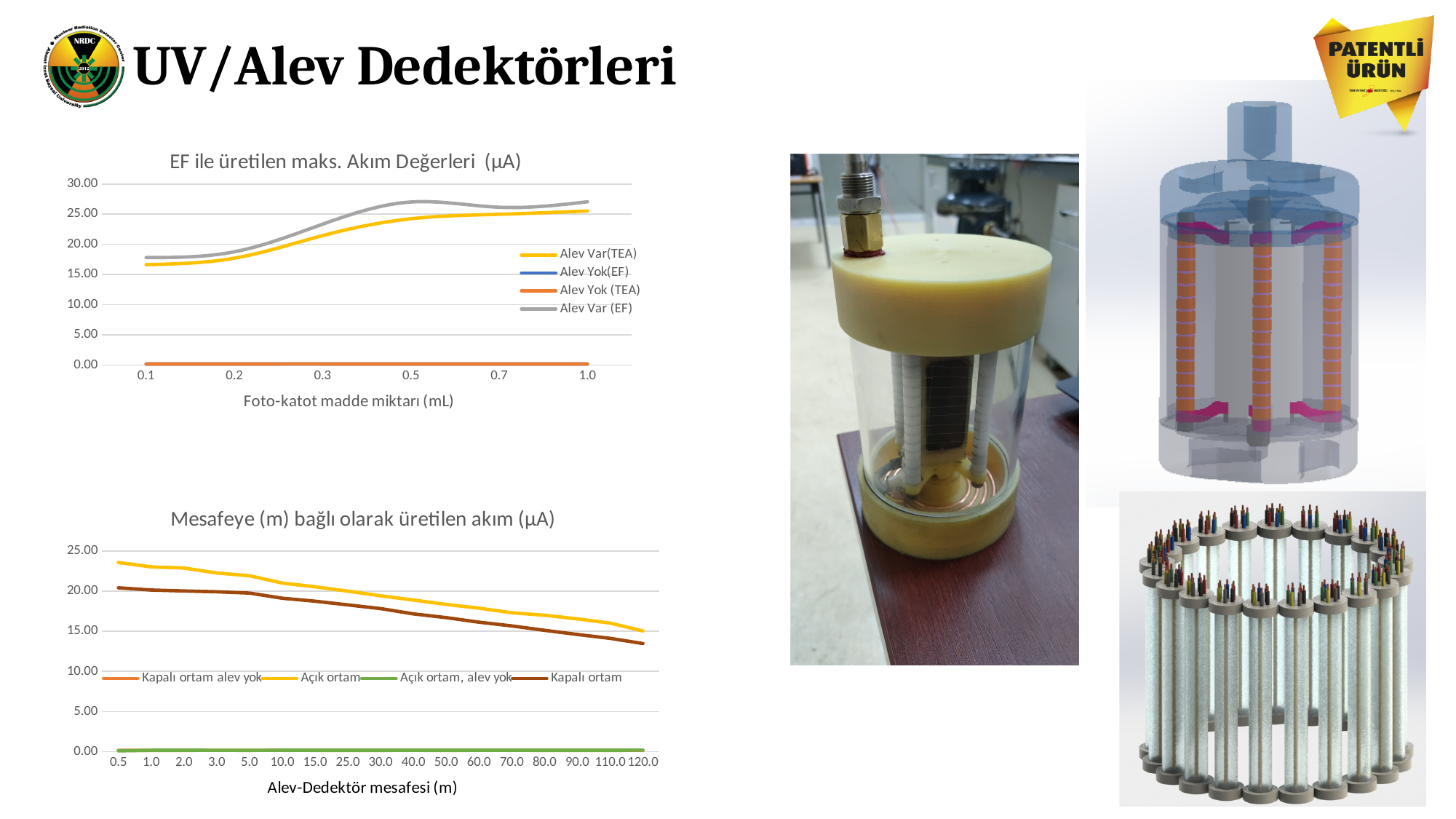
In the top chart 'EF ile üretilen maks. Akım Değerleri (µA)', how many series does the legend list? 4 In the bottom chart 'Mesafeye (m) bağlı olarak üretilen akım (µA)', does the 'Açık ortam' series rise or fall as the distance increases? fall In the top chart 'EF ile üretilen maks. Akım Değerleri (µA)', is the value of 'Alev Var(TEA)' at 0.1 mL greater or less than 20.00? less In the top chart 'EF ile üretilen maks. Akım Değerleri (µA)', how many x-axis categories are plotted? 6 In the top chart 'EF ile üretilen maks. Akım Değerleri (µA)', is the value of 'Alev Var (EF)' at 1.0 mL greater or less than 25.00? greater In the bottom chart 'Mesafeye (m) bağlı olarak üretilen akım (µA)', is the value of 'Kapalı ortam' at 120.0 m greater or less than 15.00? less In the bottom chart 'Mesafeye (m) bağlı olarak üretilen akım (µA)', how many distance values are plotted on the x axis? 17 In the bottom chart 'Mesafeye (m) bağlı olarak üretilen akım (µA)', how many series does the legend list? 4 In the top chart 'EF ile üretilen maks. Akım Değerleri (µA)', does the 'Alev Var (EF)' series rise or fall as the foto-katot madde miktarı increases from 0.1 to 1.0? rise In the bottom chart 'Mesafeye (m) bağlı olarak üretilen akım (µA)', which series is higher at 0.5 m: 'Açık ortam' or 'Kapalı ortam'? Açık ortam In the top chart 'EF ile üretilen maks. Akım Değerleri (µA)', what is the x-axis title? Foto-katot madde miktarı (mL) What kind of chart is the top chart titled 'EF ile üretilen maks. Akım Değerleri (µA)'? line chart